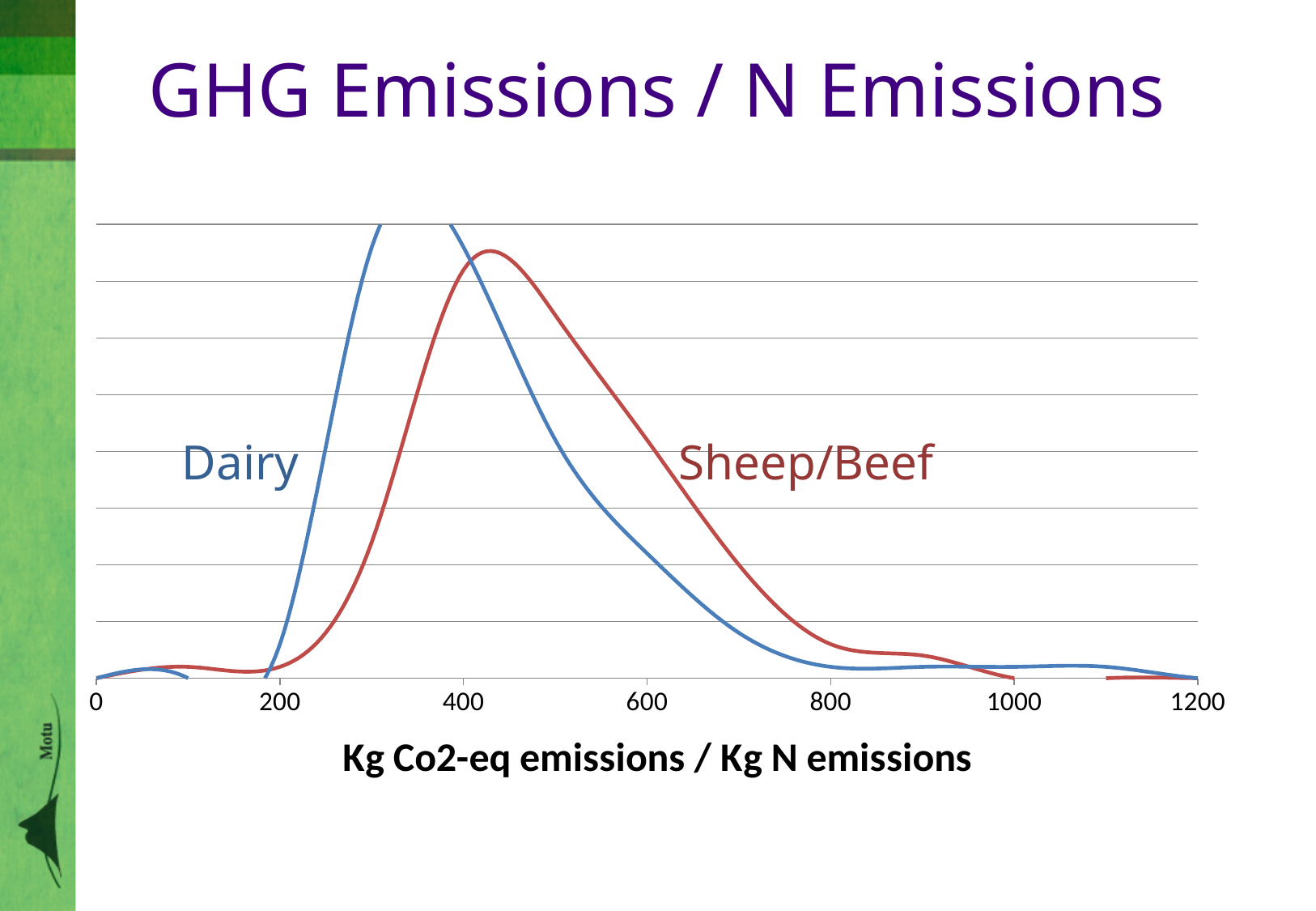
What kind of chart is shown on the slide? line chart Between x-axis values of 200 and 400, do the Sheep/Beef values rise or fall? rise What are the names of the two series plotted on the chart? Dairy and Sheep/Beef How many series are plotted on the chart? 2 At an x-axis value of 600, which series is higher, Dairy or Sheep/Beef? Sheep/Beef What is the title of the chart on the slide? GHG Emissions / N Emissions Which series peaks at a larger x-axis value, Dairy or Sheep/Beef? Sheep/Beef Is the x-axis value at which the Dairy curve peaks greater or less than 400? less Which series reaches the higher peak, Dairy or Sheep/Beef? Dairy Is the x-axis value at which the Sheep/Beef curve peaks greater or less than 400? greater Between x-axis values of 600 and 800, do the Dairy values rise or fall? fall